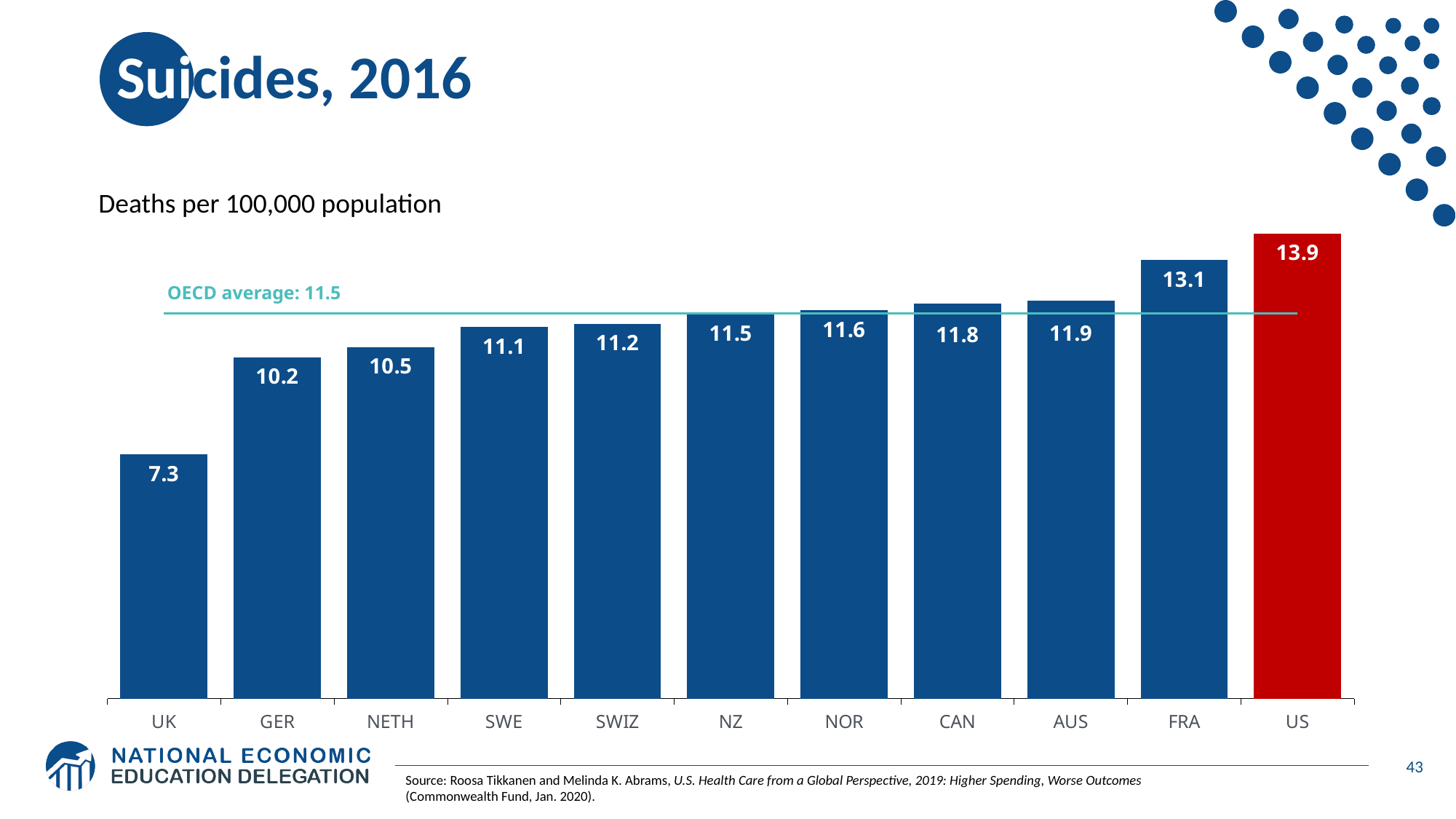
Which country has the lowest suicide rate on the chart? UK Which has a higher value, Sweden (SWE) or the Netherlands (NETH)? SWE What is the value shown for Germany (GER)? 10.2 What is the difference between the US value and the UK value? 6.6 How much higher is France's value than Australia's? 1.2 What OECD average value is marked by the horizontal line on the chart? 11.5 Which country has the highest suicide rate on the chart? US How many countries are shown on the chart? 11 What is the suicide rate shown for the US? 13.9 What value is shown for Norway (NOR)? 11.6 Do the values rise or fall moving from left to right across the chart? Rise What type of chart is shown on the slide? Bar chart